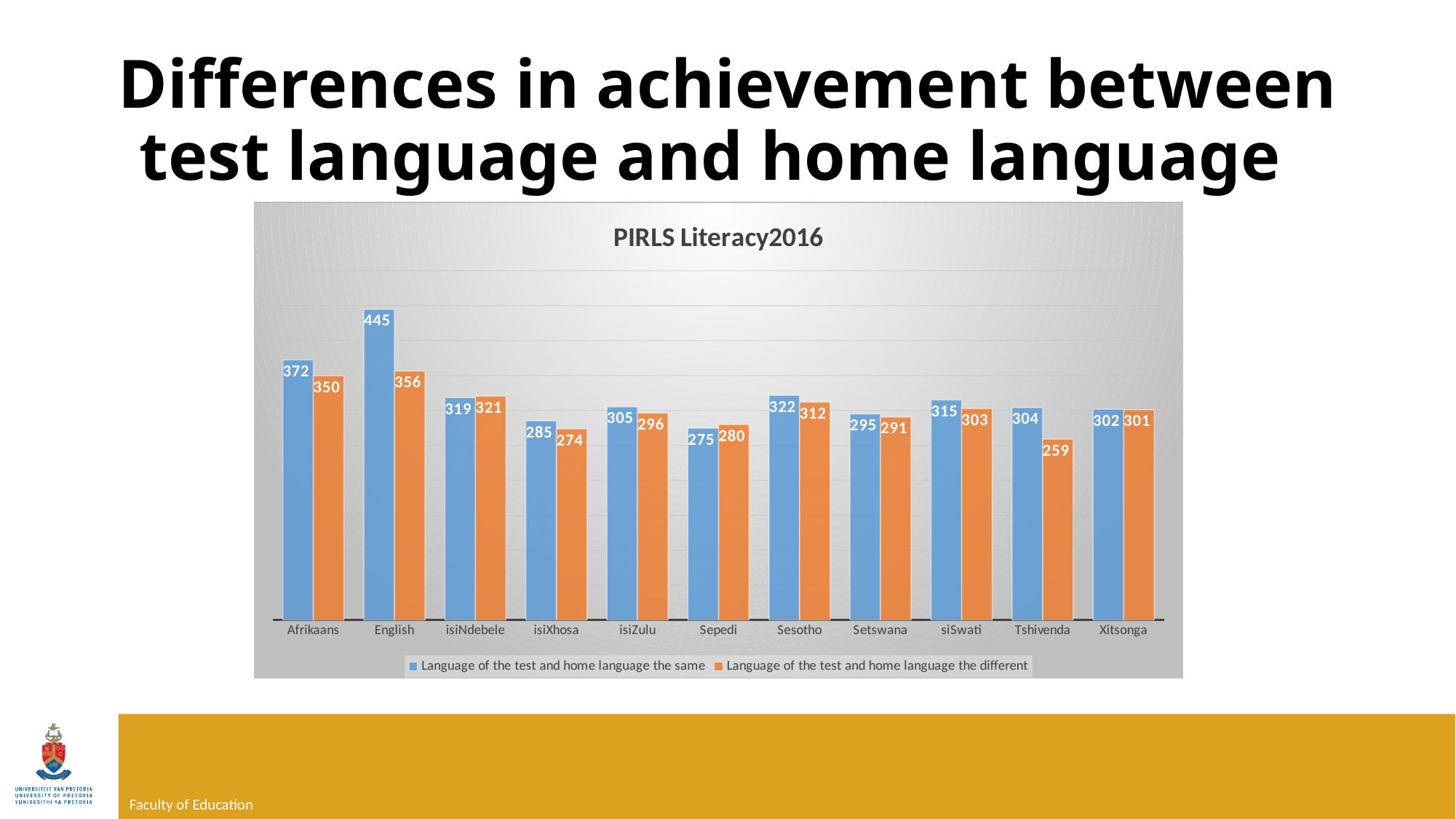
What is the value for Sepedi in the 'Language of the test and home language the same' series? 275 How many languages are shown on the x axis? 11 Which language has the highest value in the 'Language of the test and home language the same' series? English What is the value for Tshivenda in the 'Language of the test and home language the different' series? 259 Which language has the lowest value in the 'Language of the test and home language the different' series? Tshivenda What is the difference between the two series for English? 89 What is the value for English in the 'Language of the test and home language the same' series? 445 What kind of chart is shown on the slide? Bar chart What is the title of the chart? PIRLS Literacy2016 For isiNdebele, which series has the larger value? Language of the test and home language the different How many series does the legend list? 2 What is the difference between the two series for Tshivenda? 45